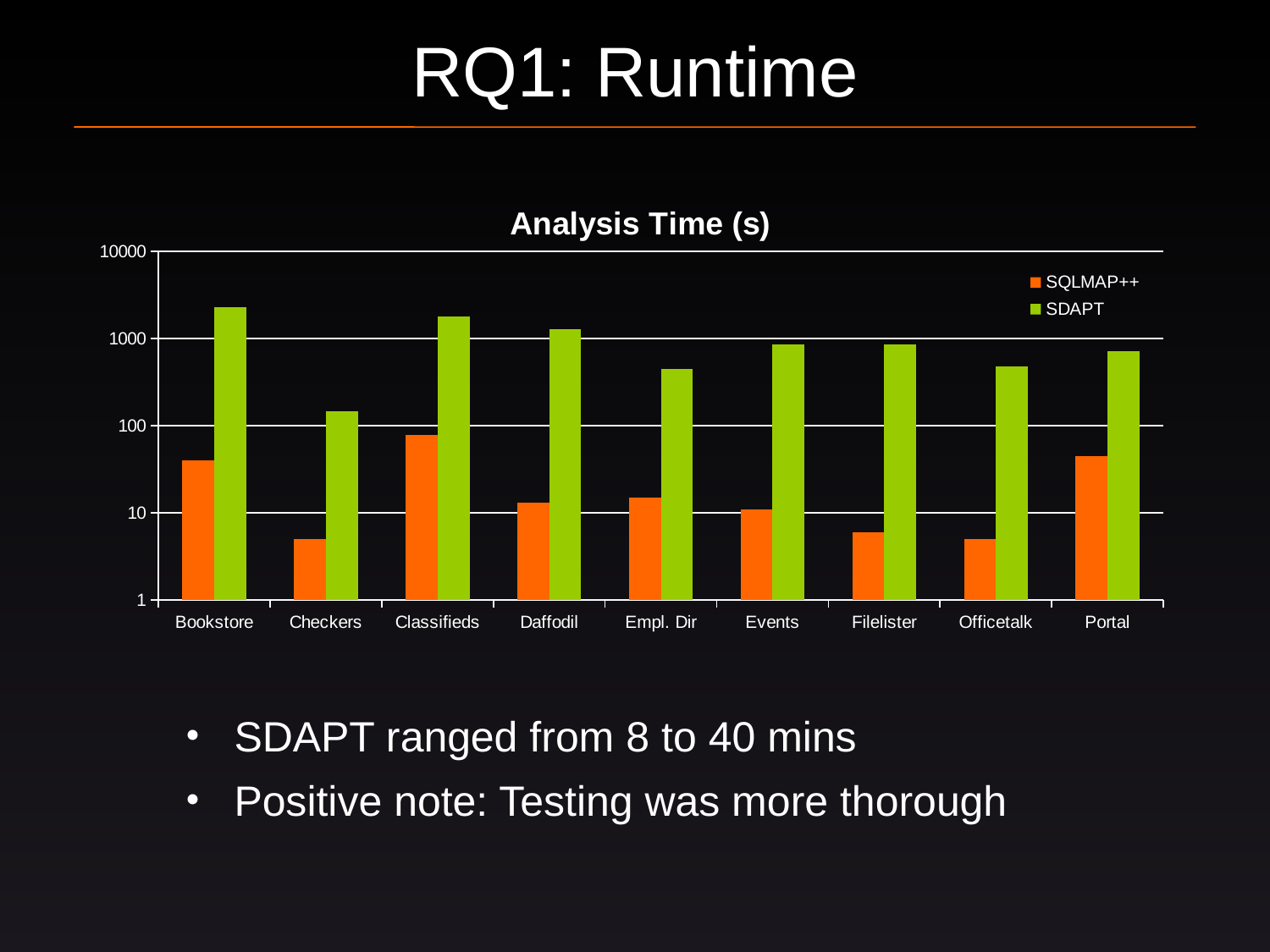
For which category is the SDAPT analysis time the lowest? Checkers For Events, which series has the larger analysis time, SQLMAP++ or SDAPT? SDAPT For which category is the SDAPT analysis time the highest? Bookstore Is the SQLMAP++ value for Checkers greater or less than 10? less Which colour represents the SDAPT series in the chart? green Is the SDAPT value for Empl. Dir greater or less than 1000? less Is the SDAPT value for Bookstore greater or less than 1000? greater How many categories are shown along the x axis of the chart? 9 How many series does the chart legend list? 2 What kind of chart is shown on the slide? bar chart What is the title of the chart? Analysis Time (s)